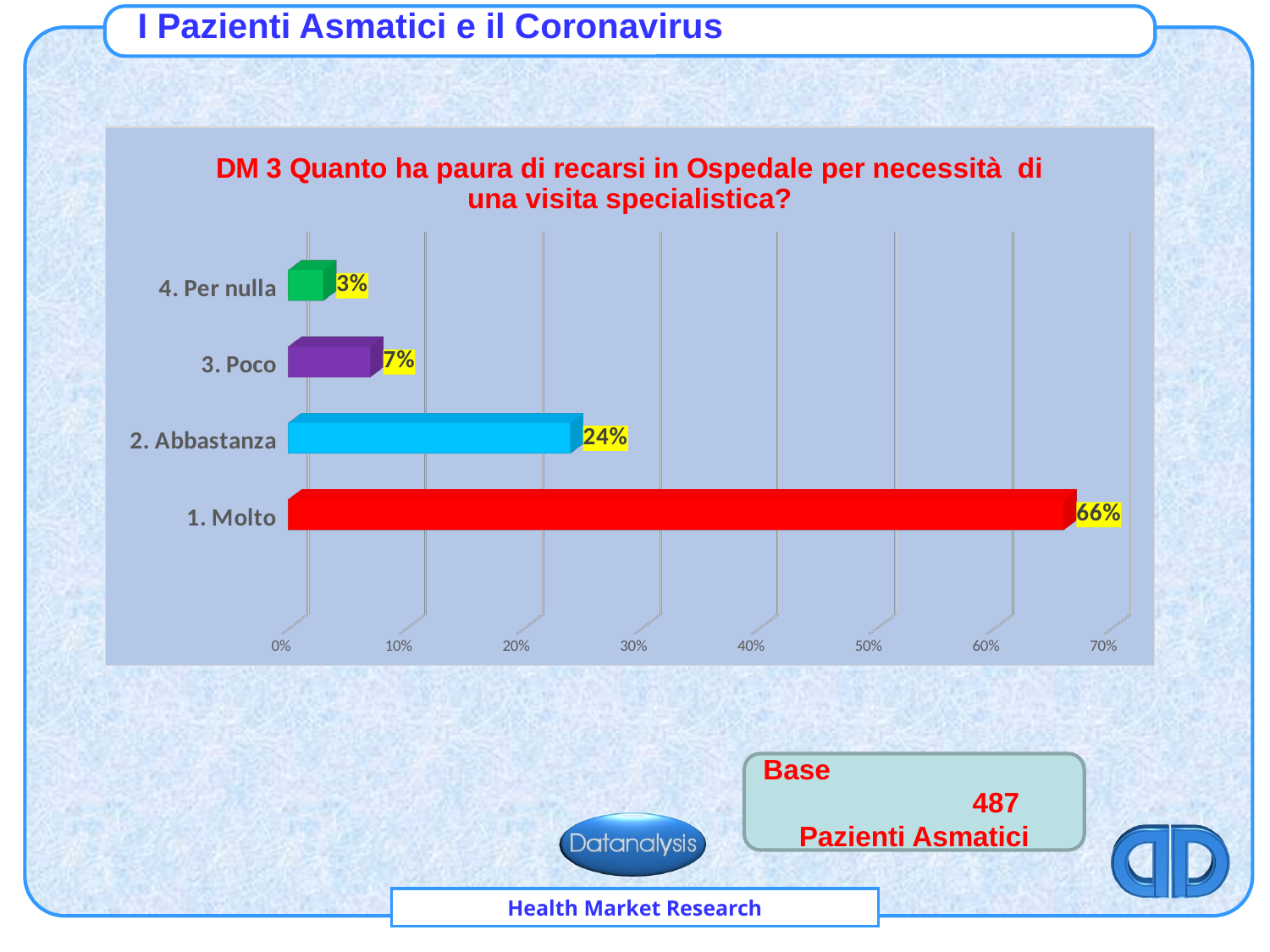
How many categories are shown in the chart? 4 What is the value for "4. Per nulla"? 3% What is the value for "2. Abbastanza"? 24% Which is larger, the value for "3. Poco" or the value for "4. Per nulla"? 3. Poco What is the value for "1. Molto"? 66% Which category has the highest value? 1. Molto What is the value for "3. Poco"? 7% Which category has the lowest value? 4. Per nulla What kind of chart is shown on the slide? bar chart Is the value for "1. Molto" greater or less than 60%? greater What is the difference between the values for "1. Molto" and "2. Abbastanza"? 42% What is the title of the chart? DM 3 Quanto ha paura di recarsi in Ospedale per necessità di una visita specialistica?